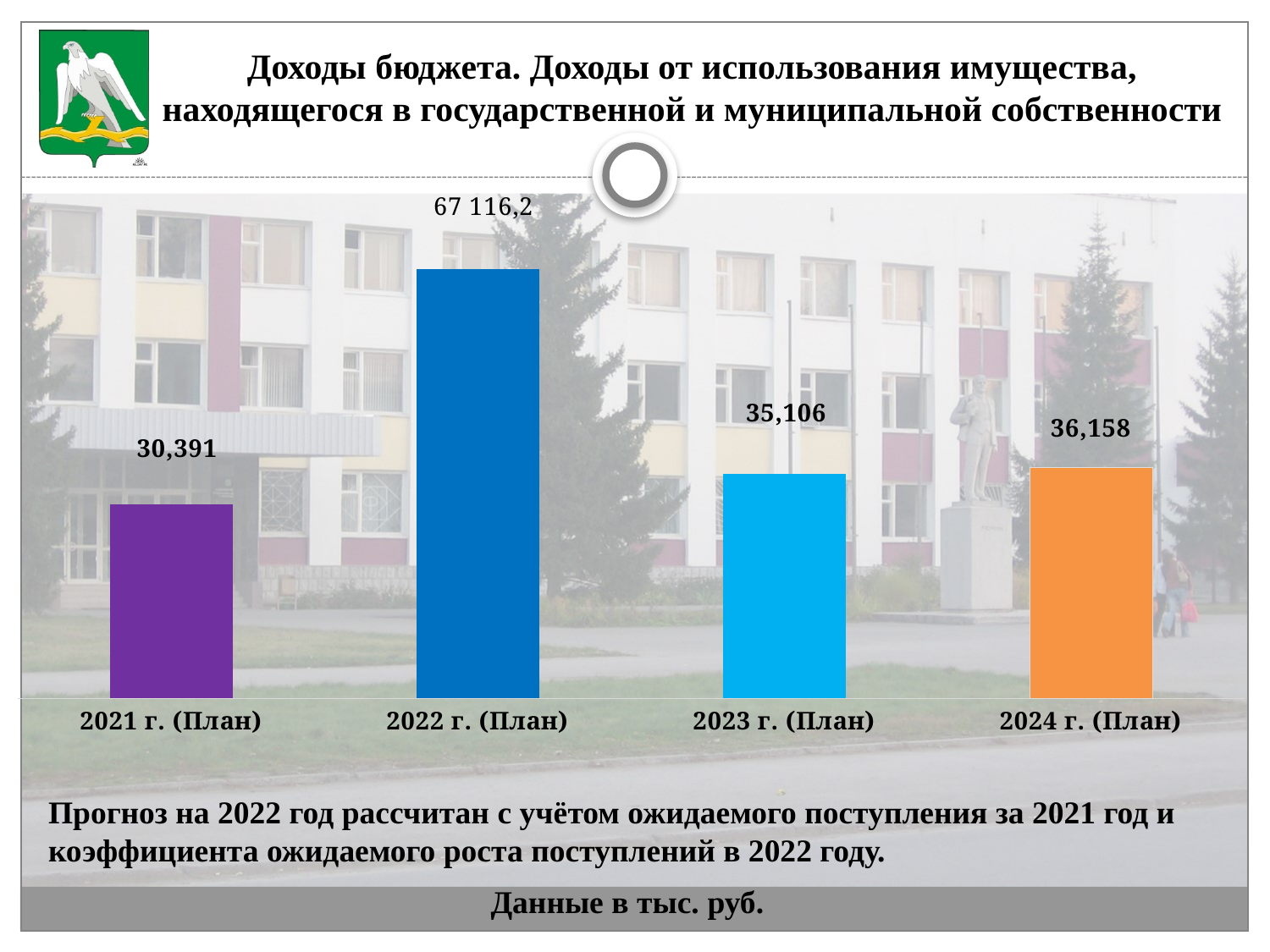
What is the difference between the values for 2023 г. (План) and 2021 г. (План)? 4,715 Which is larger, the value for 2024 г. (План) or 2023 г. (План)? 2024 г. (План) In what units are the chart's data given? тыс. руб. What is the value for 2023 г. (План)? 35,106 What is the value for 2022 г. (План)? 67 116,2 What is the value for 2021 г. (План)? 30,391 What is the value for 2024 г. (План)? 36,158 What is the difference between the values for 2024 г. (План) and 2023 г. (План)? 1,052 How many years are shown in the chart? 4 What kind of chart is shown on the slide? bar chart Which year has the highest value? 2022 г. (План) Which year has the lowest value? 2021 г. (План)